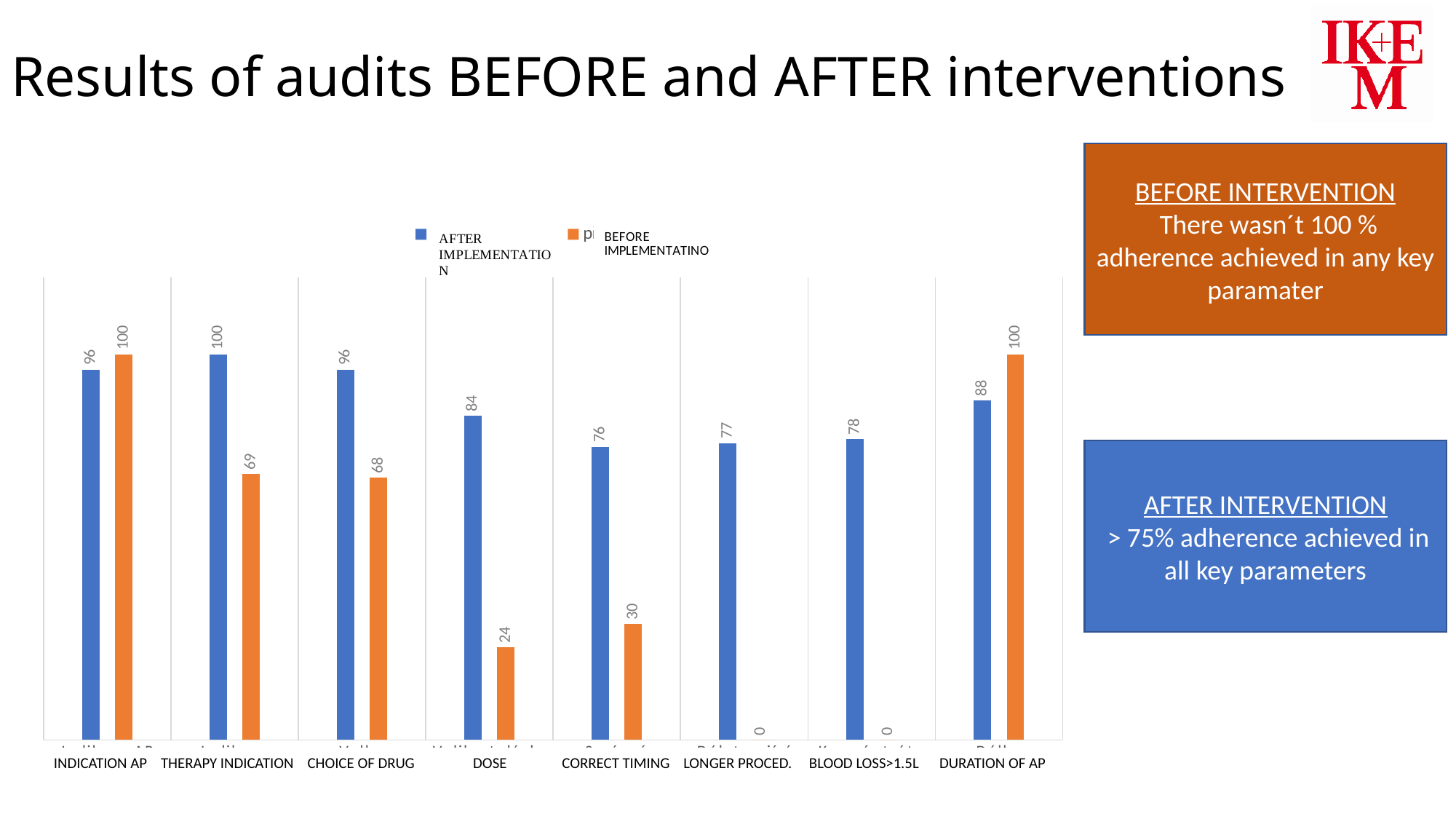
How many categories are shown on the x axis of the chart? 8 What kind of chart is shown on the slide? bar chart What is the value for DOSE in the AFTER IMPLEMENTATION series? 84 What is the value for CORRECT TIMING in the BEFORE IMPLEMENTATION series? 30 How many series does the chart legend list? 2 What is the difference between the AFTER IMPLEMENTATION and BEFORE IMPLEMENTATION values for DOSE? 60 Which category has the highest value in the AFTER IMPLEMENTATION series? THERAPY INDICATION Which category has the lowest value in the AFTER IMPLEMENTATION series? CORRECT TIMING What is the difference between the BEFORE IMPLEMENTATION and AFTER IMPLEMENTATION values for THERAPY INDICATION? 31 Which colour represents the BEFORE IMPLEMENTATION series in the chart? orange What is the value for BLOOD LOSS>1.5L in the BEFORE IMPLEMENTATION series? 0 For DURATION OF AP, which series has the larger value, AFTER IMPLEMENTATION or BEFORE IMPLEMENTATION? BEFORE IMPLEMENTATION